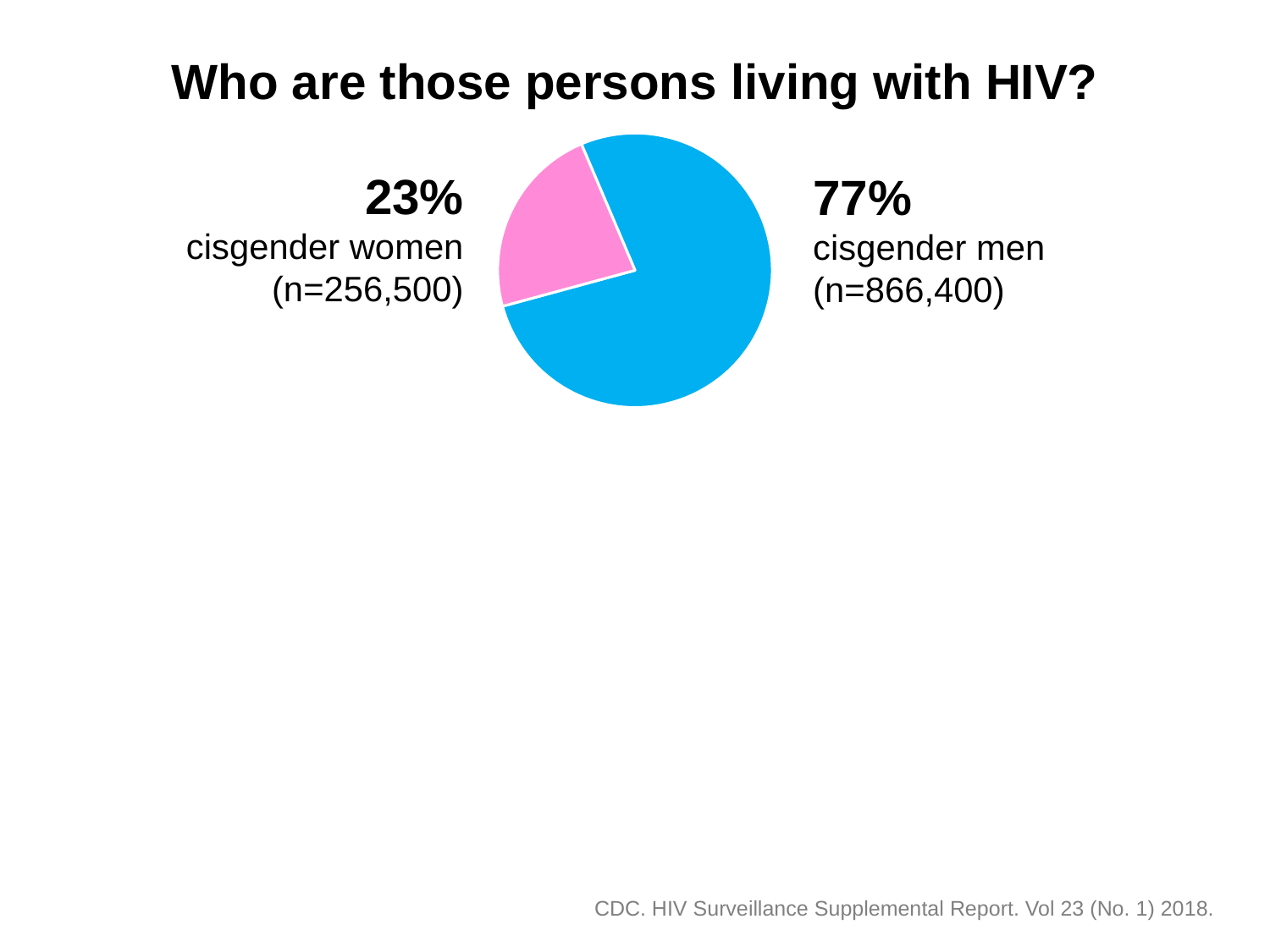
What is the title of the slide containing the pie chart? Who are those persons living with HIV? What is the number (n) of cisgender men living with HIV shown on the slide? 866,400 How many slices does the pie chart have? 2 Which group makes up the smaller share of the pie? cisgender women What kind of chart is shown on the slide? pie chart What percentage of persons living with HIV are cisgender women? 23% Which group makes up the larger share of the pie? cisgender men What percentage of persons living with HIV are cisgender men? 77% What is the difference in percentage points between the cisgender men and cisgender women shares? 54 Which is larger: the share for cisgender women or the share for cisgender men? cisgender men What is the number (n) of cisgender women living with HIV shown on the slide? 256,500 What colour is the slice representing cisgender women? pink